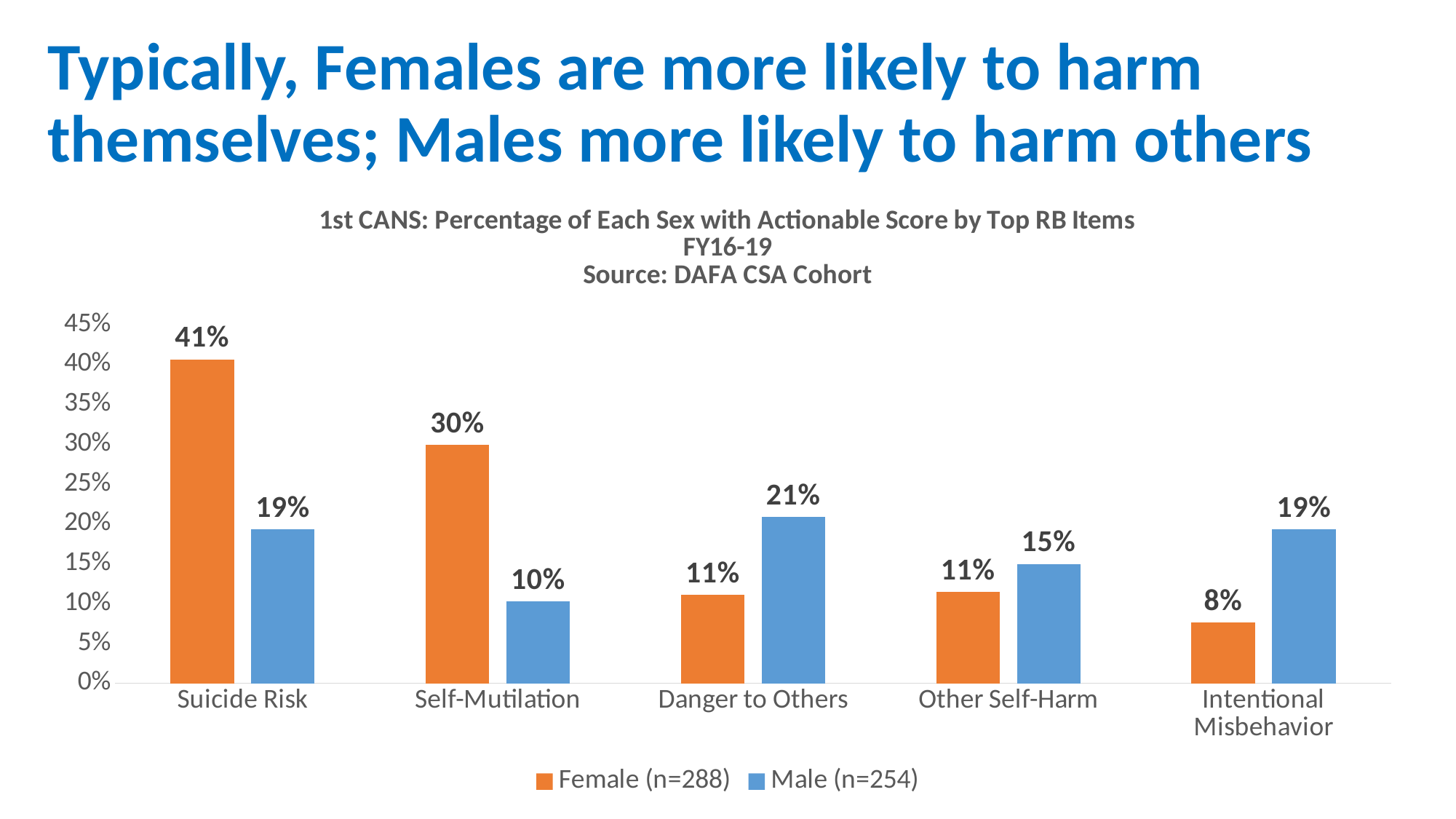
What kind of chart is shown on the slide? Bar chart Which category has the lowest Male percentage? Self-Mutilation What is the Female percentage for Suicide Risk? 41% How many categories are shown on the x axis? 5 What is the Male percentage for Danger to Others? 21% For Other Self-Harm, which is larger, the Female or the Male percentage? Male How many series does the legend list? 2 What is the Male percentage for Self-Mutilation? 10% What is the Female percentage for Intentional Misbehavior? 8% What is the difference between the Female and Male percentages for Suicide Risk? 22% Which category has the highest Female percentage? Suicide Risk What is the sample size for Males shown in the legend? n=254